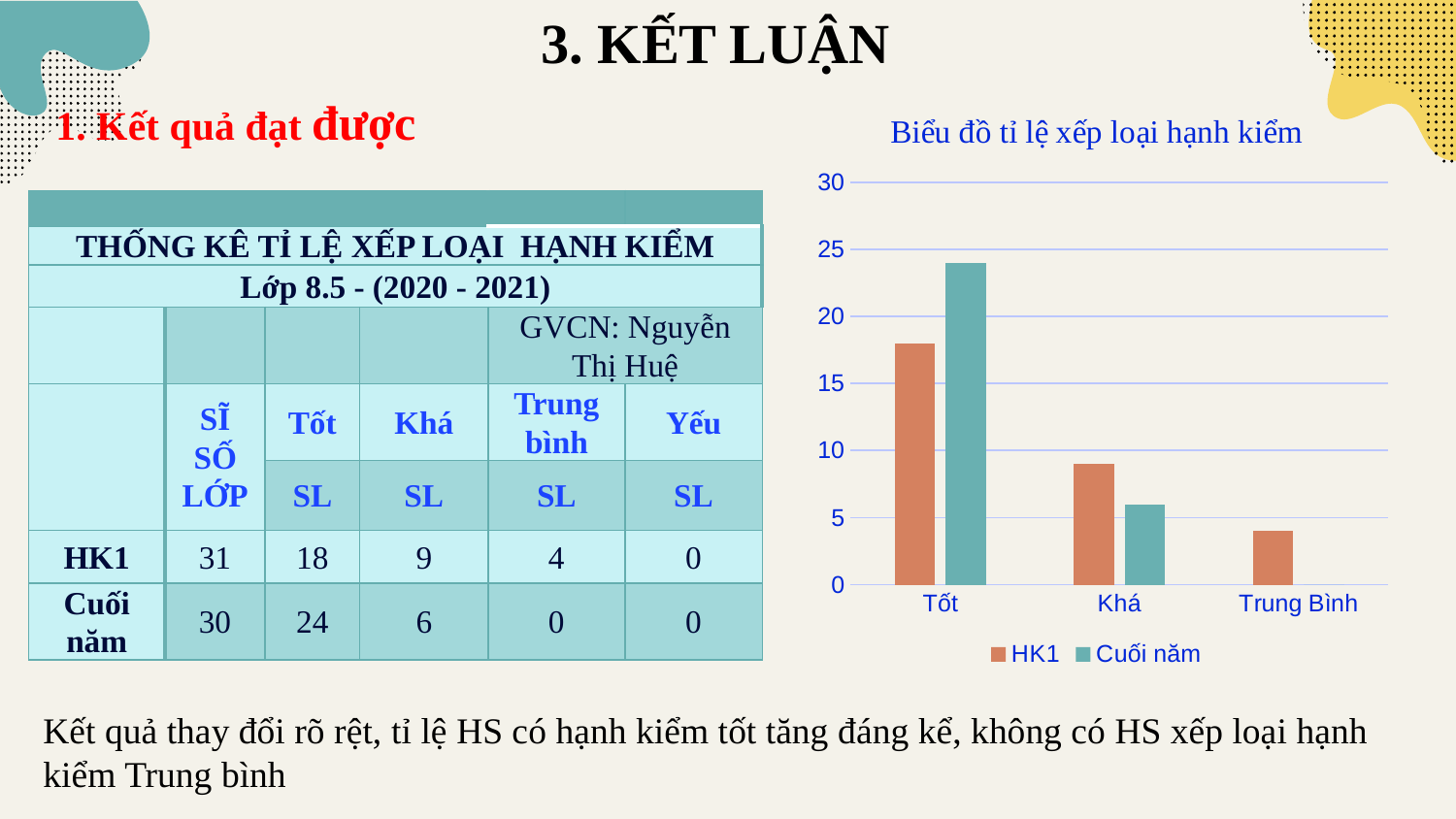
Do the HK1 values rise or fall from Tốt to Trung Bình along the x axis? fall How many series does the chart legend list? 2 Is the HK1 value for Khá greater or less than 10? less For Tốt, which series has the larger value, HK1 or Cuối năm? Cuối năm What is the title of the chart on the slide? Biểu đồ tỉ lệ xếp loại hạnh kiểm Is the Cuối năm value for Tốt greater or less than 20? greater For Khá, which series has the larger value, HK1 or Cuối năm? HK1 What kind of chart is shown on the slide? bar chart Which category has the lowest HK1 value in the chart? Trung Bình How many categories are shown on the x axis of the chart? 3 Which category has the highest Cuối năm value in the chart? Tốt Which category has the highest HK1 value in the chart? Tốt